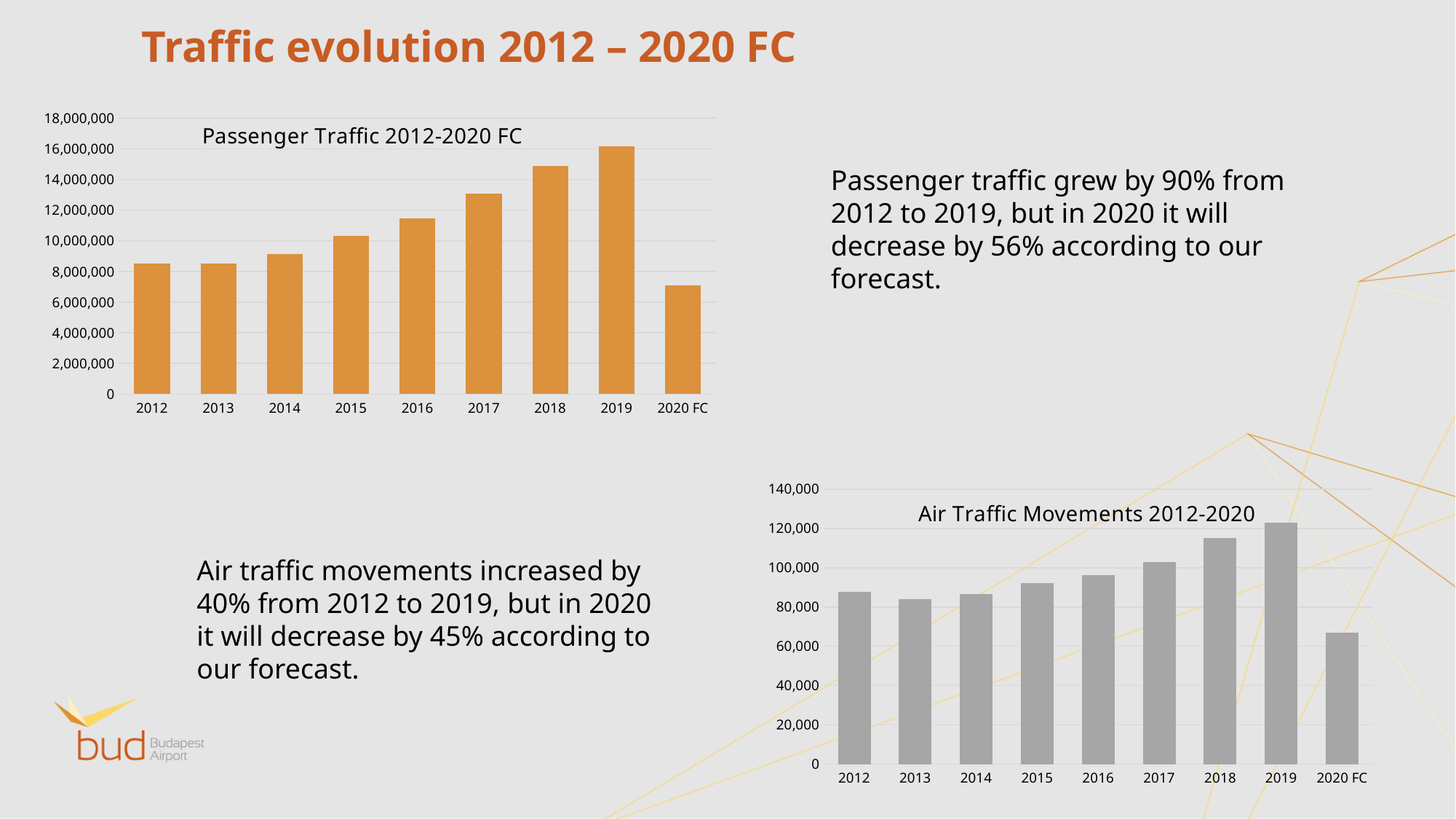
In the Passenger Traffic 2012-2020 FC chart, is the value for 2017 greater or less than 12,000,000? greater In the Passenger Traffic 2012-2020 FC chart, is the value for 2016 larger or smaller than the value for 2018? smaller In the Passenger Traffic 2012-2020 FC chart, how many years are shown on the x axis? 9 In the Passenger Traffic 2012-2020 FC chart, which year has the highest passenger traffic? 2019 In the Passenger Traffic 2012-2020 FC chart, is the value for 2020 FC greater or less than 8,000,000? less What type of chart is the Air Traffic Movements 2012-2020 chart? Bar chart In the Passenger Traffic 2012-2020 FC chart, is the value for 2018 greater or less than 14,000,000? greater In the Passenger Traffic 2012-2020 FC chart, which year has the lowest value? 2020 FC In the Air Traffic Movements 2012-2020 chart, which year has the lowest value? 2020 FC In the Air Traffic Movements 2012-2020 chart, which year has the highest value? 2019